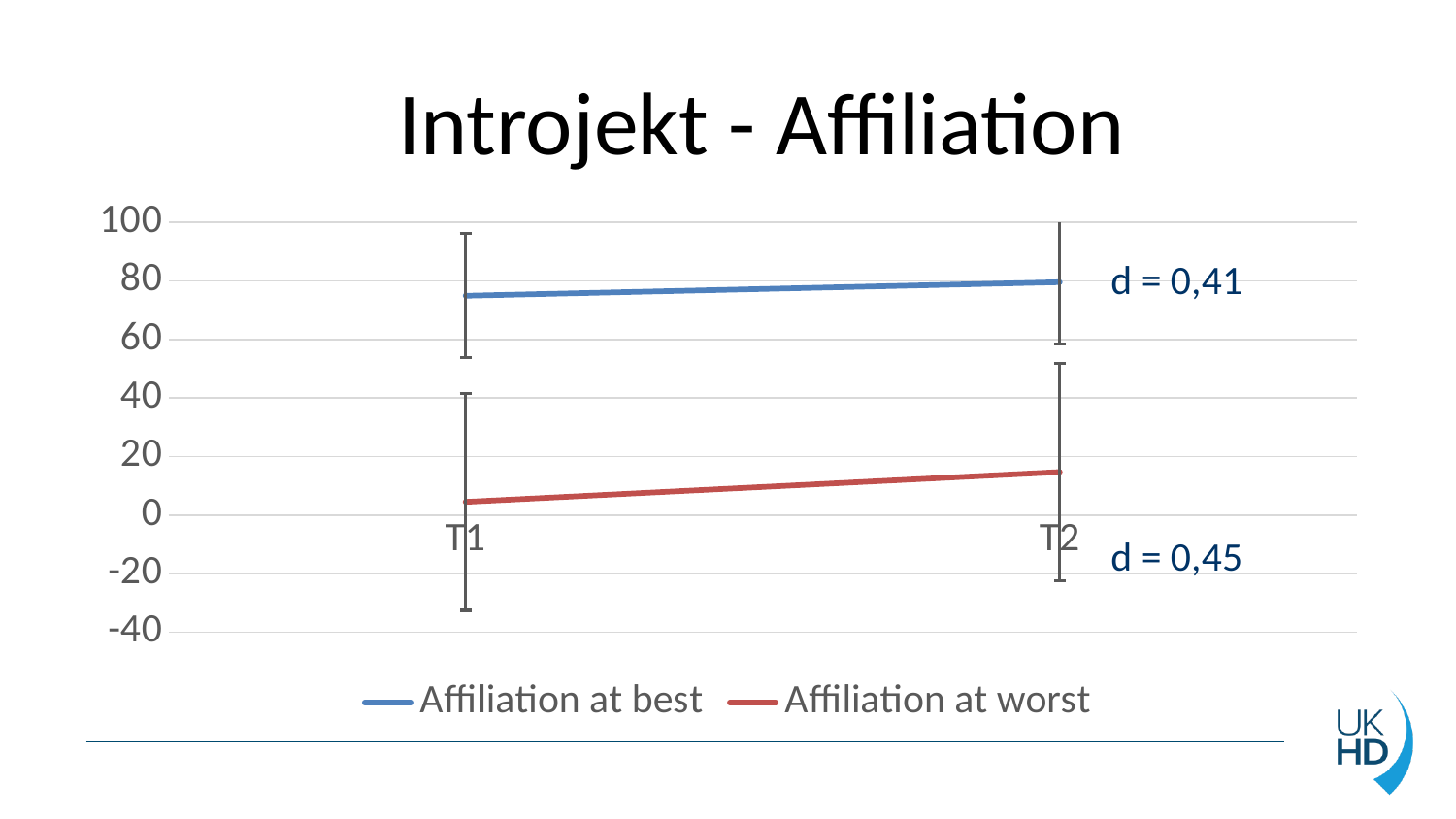
What is the title of the chart? Introjekt - Affiliation What kind of chart is shown on the slide? line chart How many series does the legend list? 2 Is the value for Affiliation at best at T2 greater or less than 100? less Does the Affiliation at best line rise or fall from T1 to T2? rise Is the value for Affiliation at worst at T2 greater or less than 40? less Which series is plotted in red? Affiliation at worst Is the value for Affiliation at worst at T1 greater or less than 20? less Does the Affiliation at worst line rise or fall from T1 to T2? rise Which series has the higher value at T2, Affiliation at best or Affiliation at worst? Affiliation at best How many time points are shown on the x axis? 2